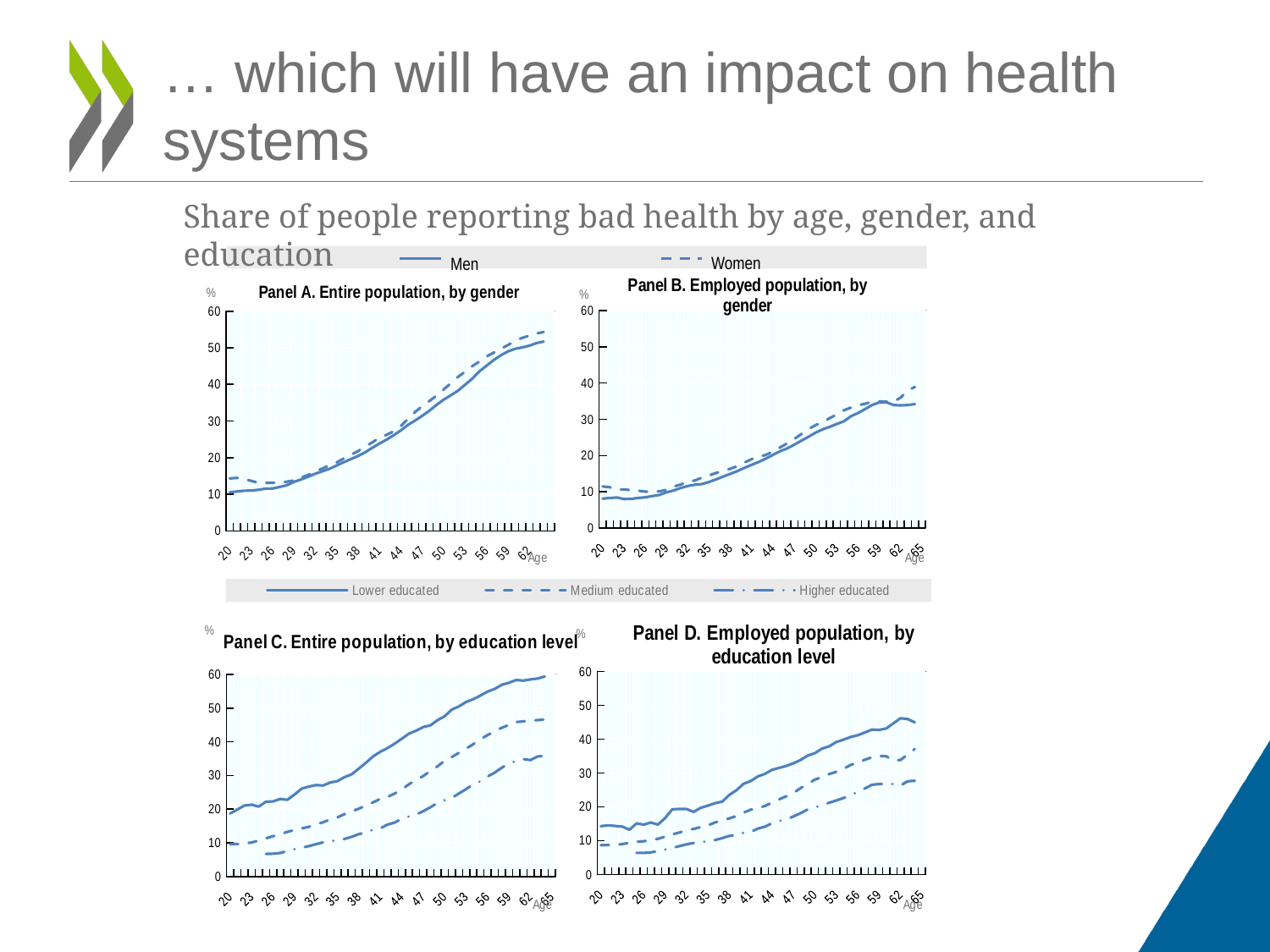
What kind of chart is Panel A. Entire population, by gender? Line chart What is the overall subtitle describing the charts on the slide? Share of people reporting bad health by age, gender, and education In Panel B. Employed population, by gender, is the value for Men at age 65 greater or less than 40? less How many series does the legend for Panel A. Entire population, by gender list? 2 How many series does the legend for Panel C. Entire population, by education level list? 3 In Panel C. Entire population, by education level, which series is higher at age 65: Lower educated or Higher educated? Lower educated In Panel A. Entire population, by gender, does the share for Men rise or fall as age increases? Rise In Panel C. Entire population, by education level, is the value for Lower educated at age 65 greater or less than 50? greater In Panel D. Employed population, by education level, which series is lowest at age 65? Higher educated In Panel A. Entire population, by gender, is the value for Men at age 20 greater or less than 20? less